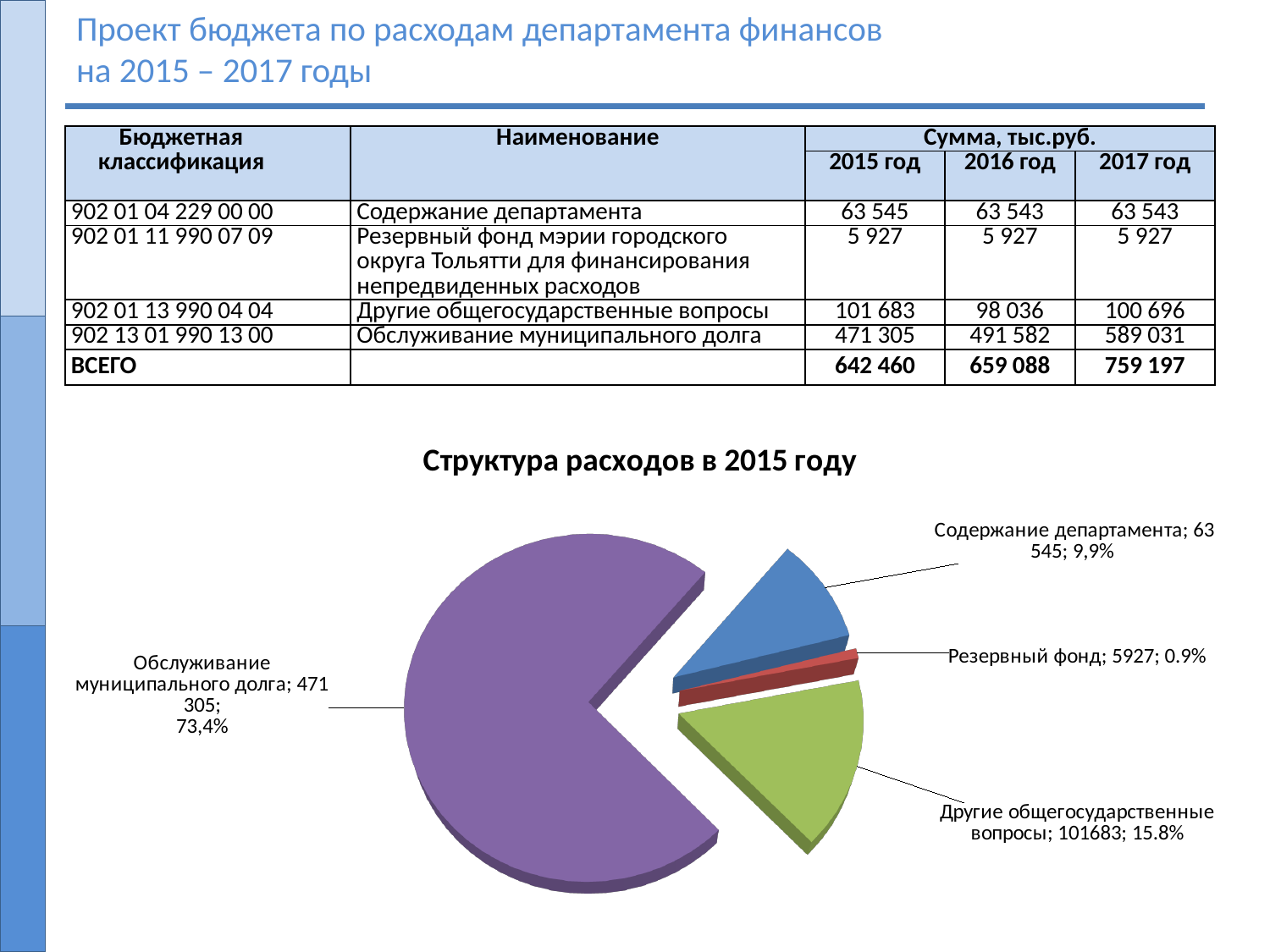
Which slice of the pie chart is the smallest? Резервный фонд How many slices does the pie chart have? 4 What share of the pie does Резервный фонд have? 0.9% What type of chart is shown on the slide? pie chart What value is shown for Обслуживание муниципального долга in the pie chart? 471 305 What share of the pie does Содержание департамента have? 9,9% Which is larger in the pie chart: Содержание департамента or Другие общегосударственные вопросы? Другие общегосударственные вопросы Which slice of the pie chart is the largest? Обслуживание муниципального долга What is the title of the chart? Структура расходов в 2015 году What share of the pie does Обслуживание муниципального долга have? 73,4% What value is shown for Другие общегосударственные вопросы in the pie chart? 101683